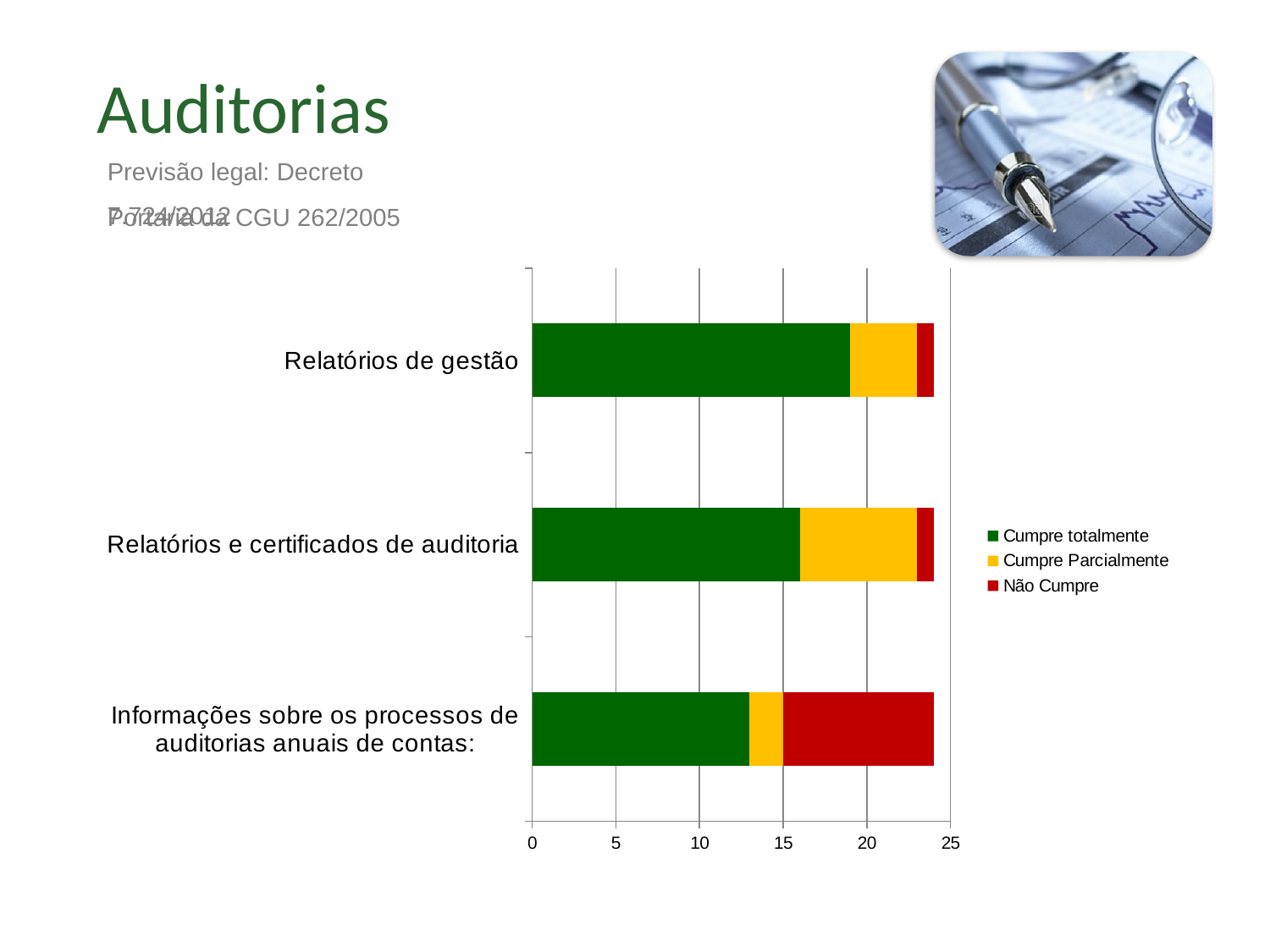
Which category has the largest 'Cumpre totalmente' segment? Relatórios de gestão Is the 'Não Cumpre' value for Informações sobre os processos de auditorias anuais de contas greater or less than 5? greater Is the 'Cumpre totalmente' value for Informações sobre os processos de auditorias anuais de contas greater or less than 15? less Which category has the largest 'Cumpre Parcialmente' segment? Relatórios e certificados de auditoria Which has the larger 'Cumpre totalmente' segment: Relatórios de gestão or Relatórios e certificados de auditoria? Relatórios de gestão Which category has the smallest 'Cumpre totalmente' segment? Informações sobre os processos de auditorias anuais de contas: What colour represents 'Não Cumpre' in the chart? Red What kind of chart is shown on the slide? Stacked bar chart How many categories are plotted on the chart? 3 How many series does the chart legend list? 3 Is the 'Cumpre totalmente' value for Relatórios de gestão greater or less than 15? greater Which category has the largest 'Não Cumpre' segment? Informações sobre os processos de auditorias anuais de contas: